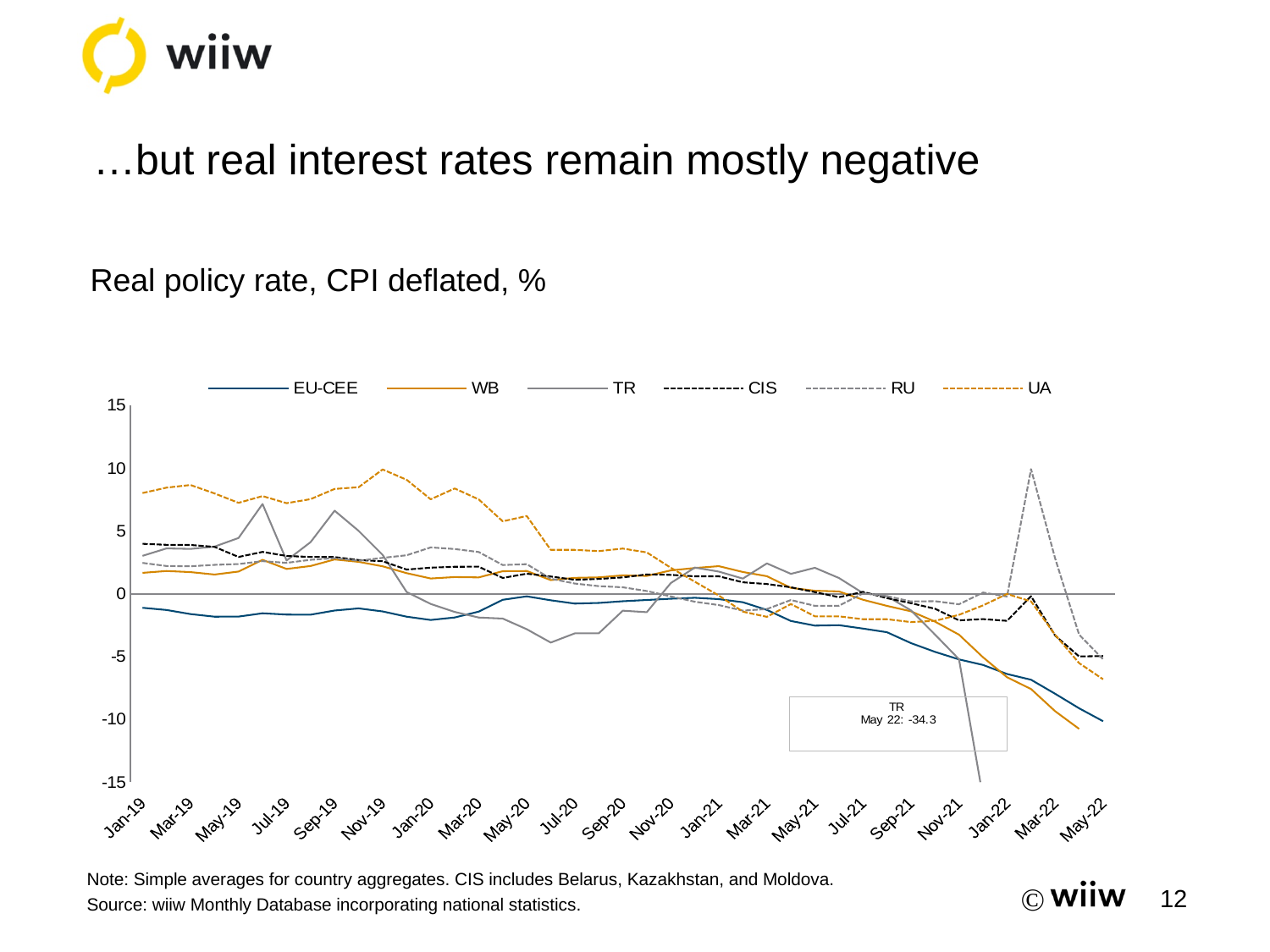
Is the value for UA in Nov-19 greater or less than 5? greater Which series has the highest value in Jan-19? UA Is the value for EU-CEE in May-22 greater or less than -5? less In Jan-19, which is higher, UA or EU-CEE? UA What kind of chart is shown on the slide? line chart How many labels are shown on the x axis? 21 What is the value for TR in May 22, as given in the annotation box? -34.3 Does the EU-CEE line rise or fall between Jan-21 and May-22? fall What is the title of the chart? Real policy rate, CPI deflated, % How many series does the legend list? 6 Which series has the lowest value in May-22? TR